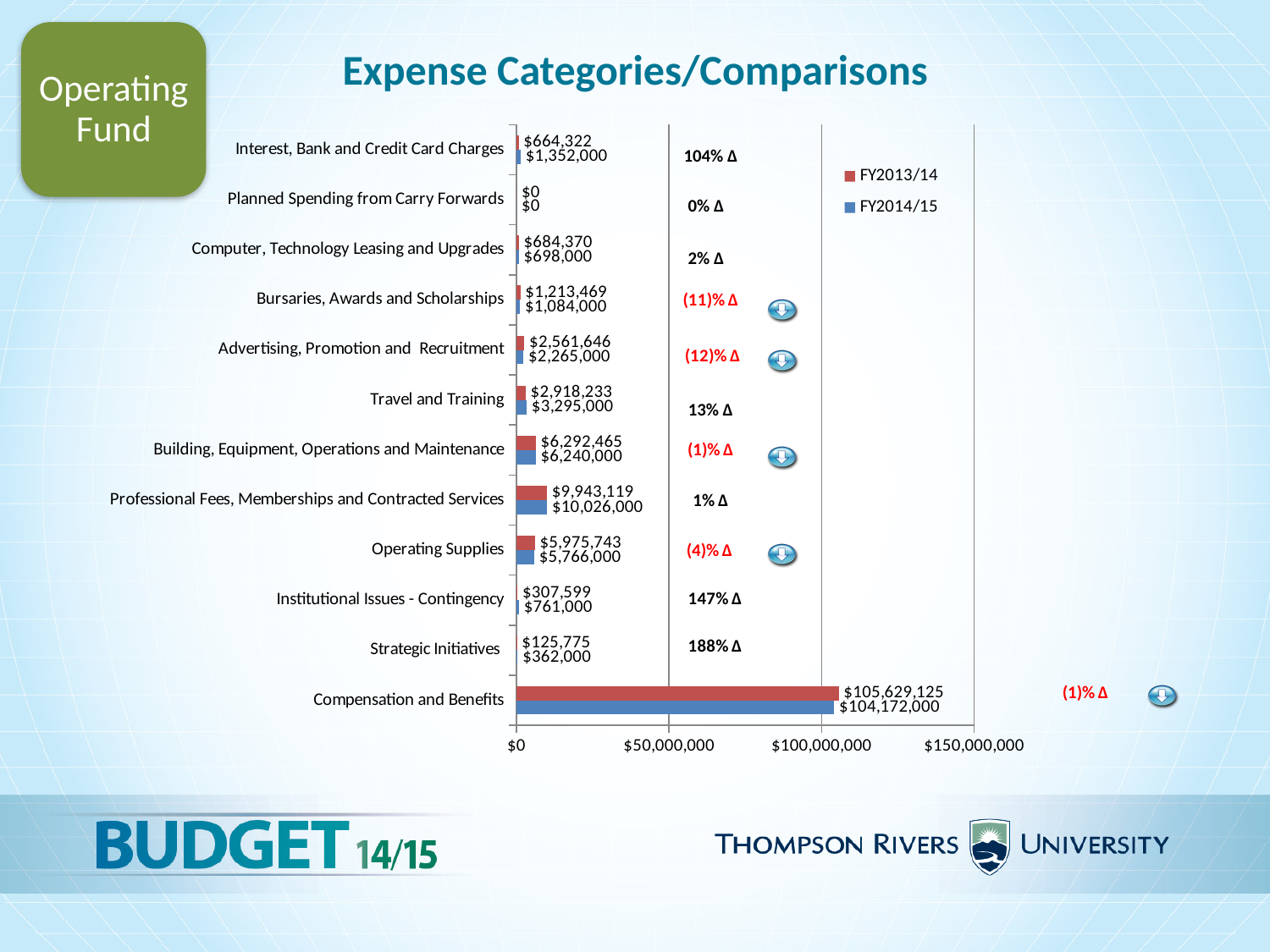
Which is larger for Operating Supplies: the FY2013/14 value or the FY2014/15 value? FY2013/14 Is the FY2014/15 value for Compensation and Benefits greater or less than $100,000,000? greater How many expense categories are shown on the chart? 12 What is the FY2014/15 value for Travel and Training? $3,295,000 Which expense category has the highest FY2014/15 value? Compensation and Benefits Which expense category has the lowest FY2013/14 value? Planned Spending from Carry Forwards What is the FY2014/15 value for Professional Fees, Memberships and Contracted Services? $10,026,000 How many series does the legend list? 2 What is the FY2013/14 value for Compensation and Benefits? $105,629,125 What is the FY2013/14 value for Interest, Bank and Credit Card Charges? $664,322 What kind of chart is shown on the slide? Bar chart What is the difference between the FY2014/15 and FY2013/14 values for Travel and Training? $376,767